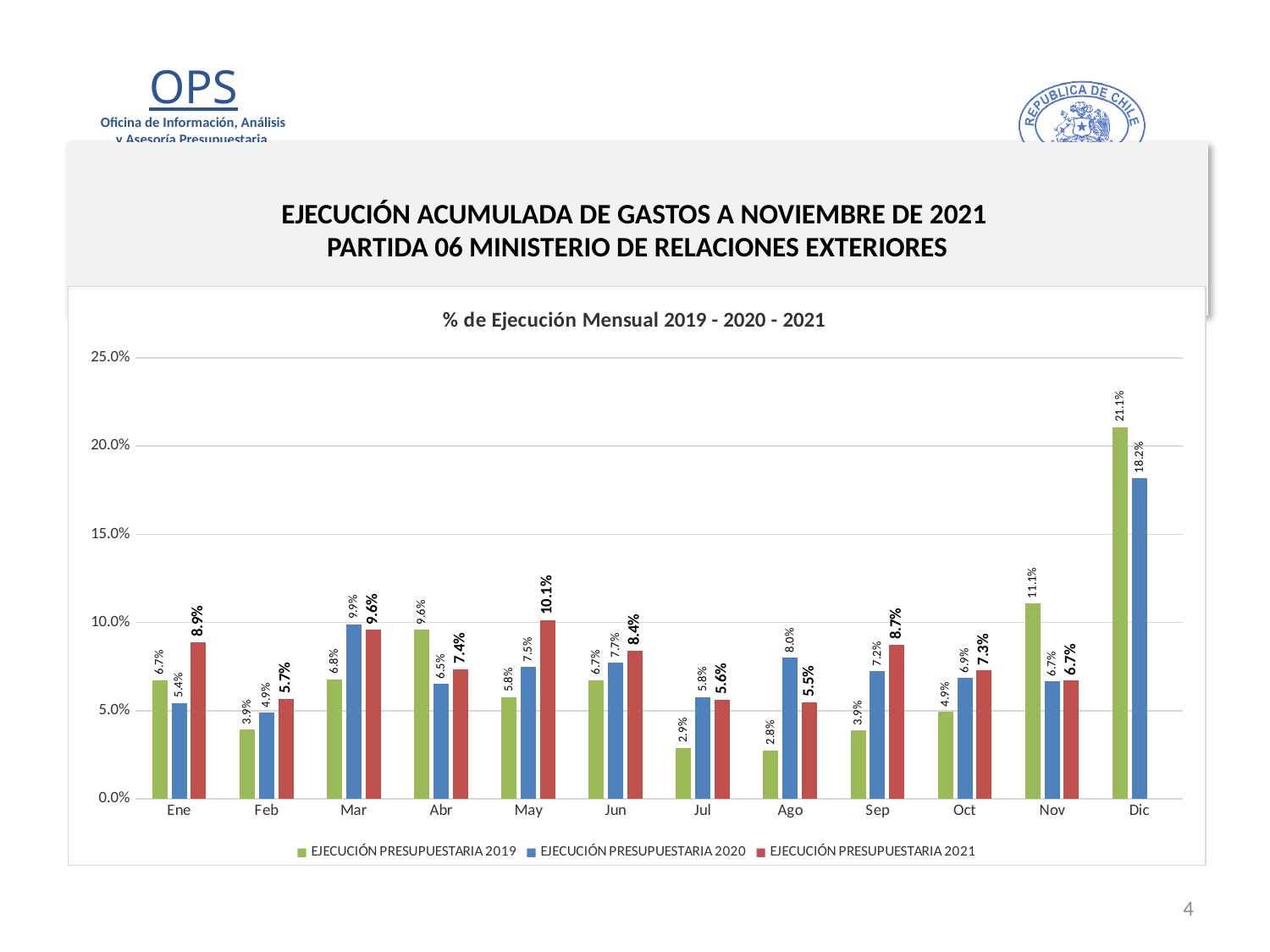
In Mar, which is larger: the 2020 value or the 2021 value? 2020 What is the title of the chart? % de Ejecución Mensual 2019 - 2020 - 2021 How many series does the legend list? 3 Which month has the lowest value for EJECUCIÓN PRESUPUESTARIA 2019? Ago What kind of chart is shown? bar chart How many months are shown on the x axis? 12 Which month has the highest value for EJECUCIÓN PRESUPUESTARIA 2021? May What is the value for EJECUCIÓN PRESUPUESTARIA 2021 in May? 10.1% What is the value for EJECUCIÓN PRESUPUESTARIA 2020 in Ago? 8.0% What is the difference between the 2019 and 2020 values in Dic? 2.9% What is the value for EJECUCIÓN PRESUPUESTARIA 2019 in Dic? 21.1% Is the value for EJECUCIÓN PRESUPUESTARIA 2020 in Dic greater or less than 15.0%? greater